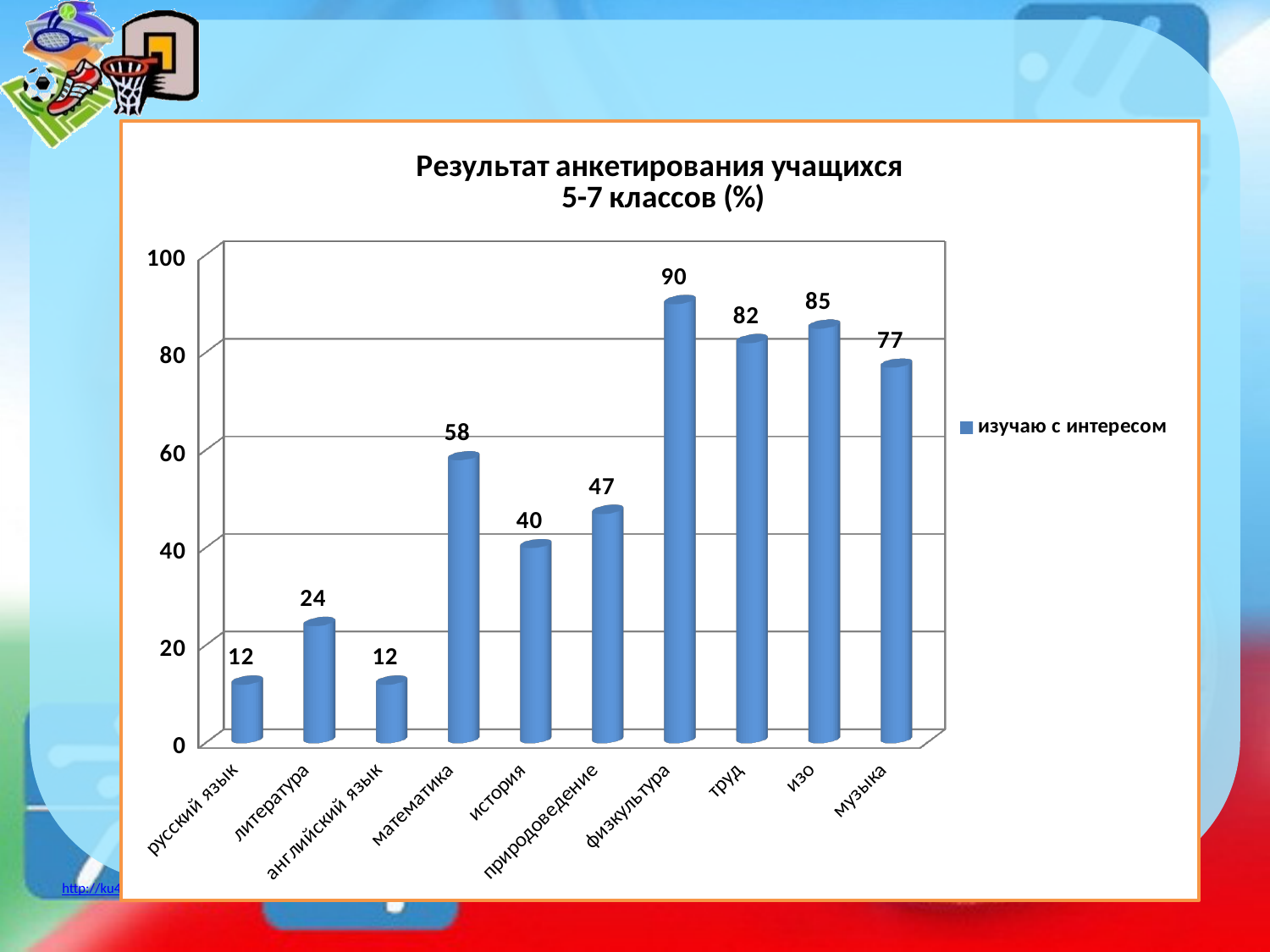
What is the value for математика? 58 What is the legend entry for the series? изучаю с интересом How many series does the legend list? 1 What is the value for физкультура? 90 Is the value for труд greater or less than 80? greater What kind of chart is shown on the slide? bar chart How many categories are shown on the x axis? 10 What is the value for музыка? 77 What is the difference between the values for изо and труд? 3 Which category has the highest value? физкультура Which is larger, the value for природоведение or the value for литература? природоведение What is the difference between the values for математика and история? 18